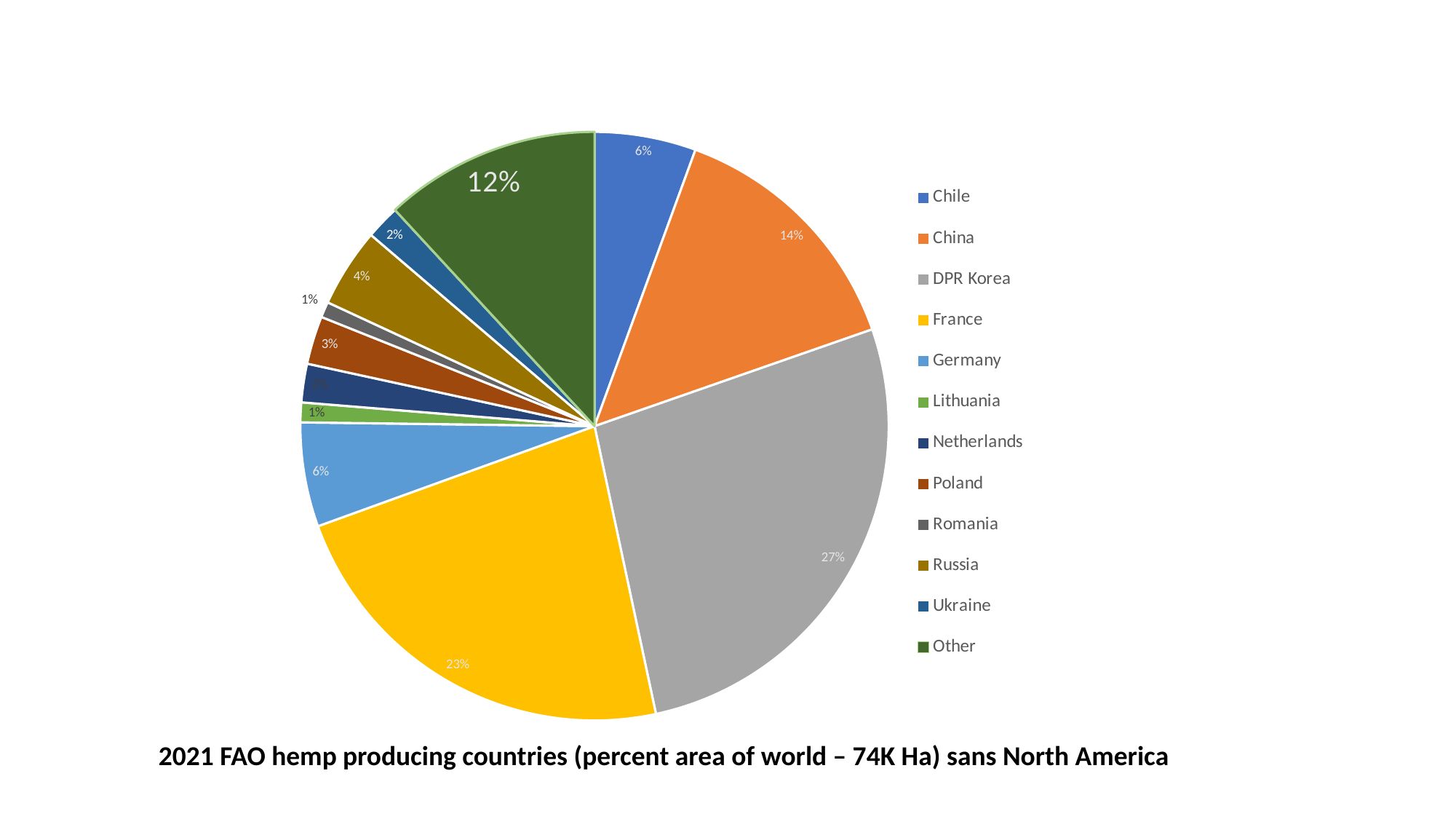
How many categories does the legend list? 12 What percentage is shown for Russia? 4% What percentage is shown for China? 14% How many percentage points larger is DPR Korea's share than France's? 4 What share of the pie does DPR Korea hold? 27% What is the caption text shown below the pie chart? 2021 FAO hemp producing countries (percent area of world – 74K Ha) sans North America Which country has the largest slice of the pie? DPR Korea What percentage is shown for France? 23% What share of the pie is labelled for the Other category? 12% What percentage is shown for Poland? 3% Which slice is larger, China or Other? China What kind of chart is shown on the slide? pie chart